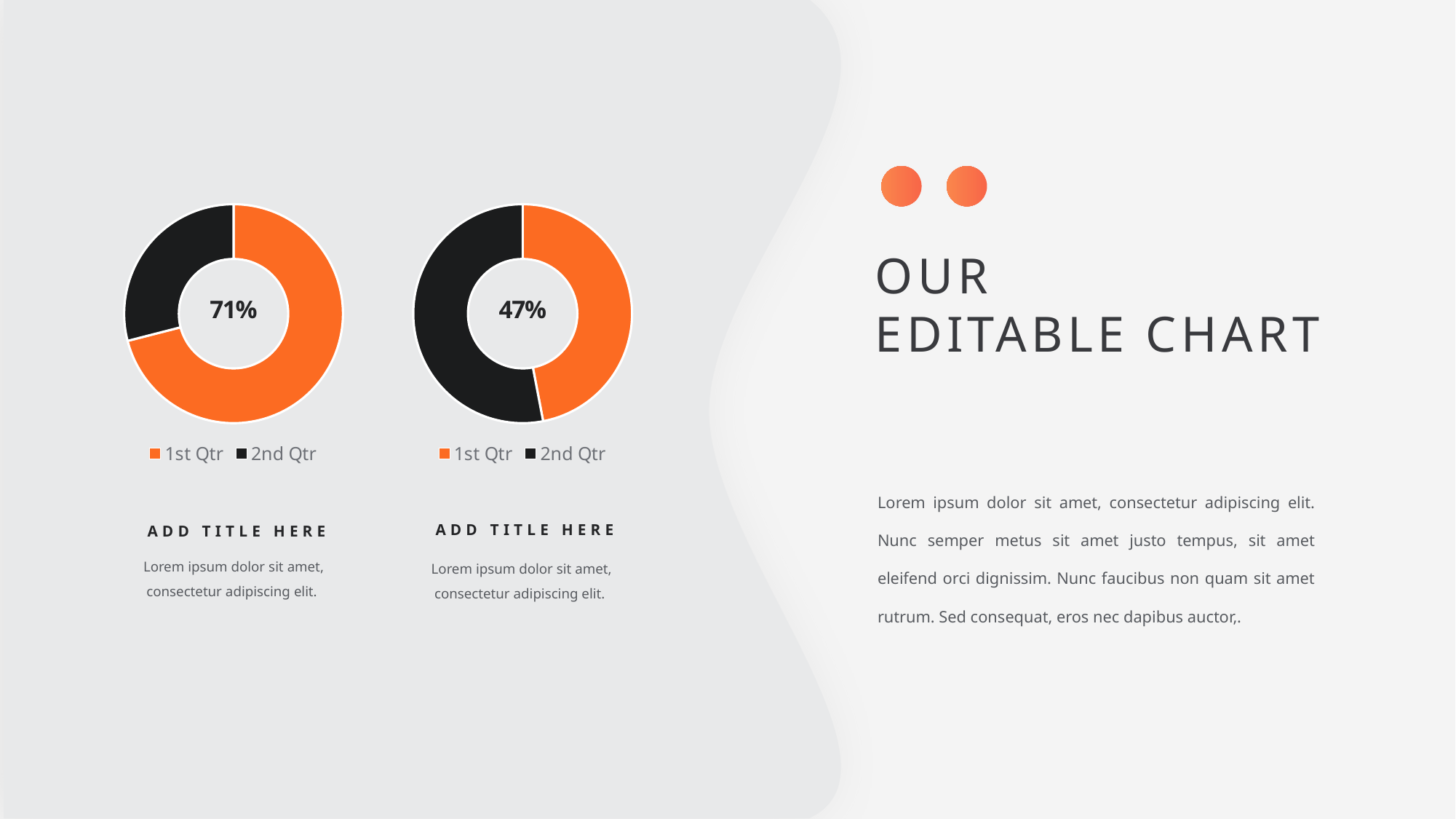
What kind of chart is the left chart on the slide? Doughnut chart How many entries does the legend of the right doughnut chart list? 2 What percentage is printed in the centre of the left doughnut chart? 71% How many slices does the right doughnut chart have? 2 What kind of chart is the right chart on the slide? Doughnut chart Which chart shows the larger centre percentage, the left doughnut chart or the right doughnut chart? The left chart How many slices does the left doughnut chart have? 2 What colour represents 1st Qtr in the legend of the left doughnut chart? Orange In the left doughnut chart, which slice is larger, 1st Qtr or 2nd Qtr? 1st Qtr What percentage is printed in the centre of the right doughnut chart? 47% How many entries does the legend of the left doughnut chart list? 2 What colour represents 2nd Qtr in the legend of the right doughnut chart? Black